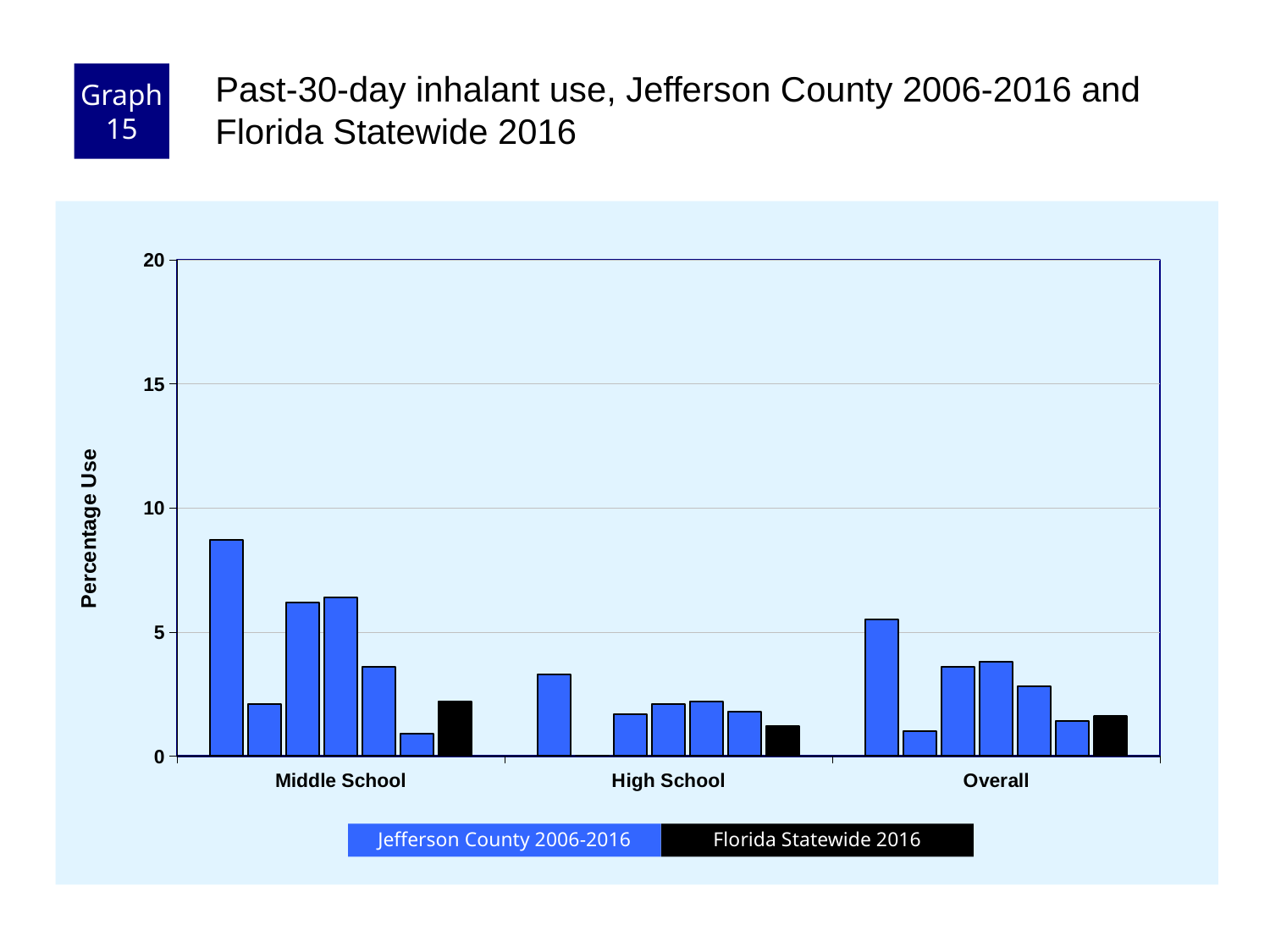
Which is larger, the tallest Jefferson County bar in the Middle School group or the tallest Jefferson County bar in the High School group? Middle School Is the tallest Jefferson County bar in the Middle School group greater or less than 5? greater Is the tallest Jefferson County bar in the Overall group greater or less than 10? less What kind of chart is shown on the slide? bar chart How many categories are shown on the x axis? 3 Which is larger, the Florida Statewide 2016 value for Middle School or for High School? Middle School Which category group contains the tallest bar on the chart? Middle School What is the title of the y axis? Percentage Use How many series does the legend list? 2 Is the Florida Statewide 2016 value for Middle School greater or less than 5? less Which colour represents Florida Statewide 2016 in the legend? black